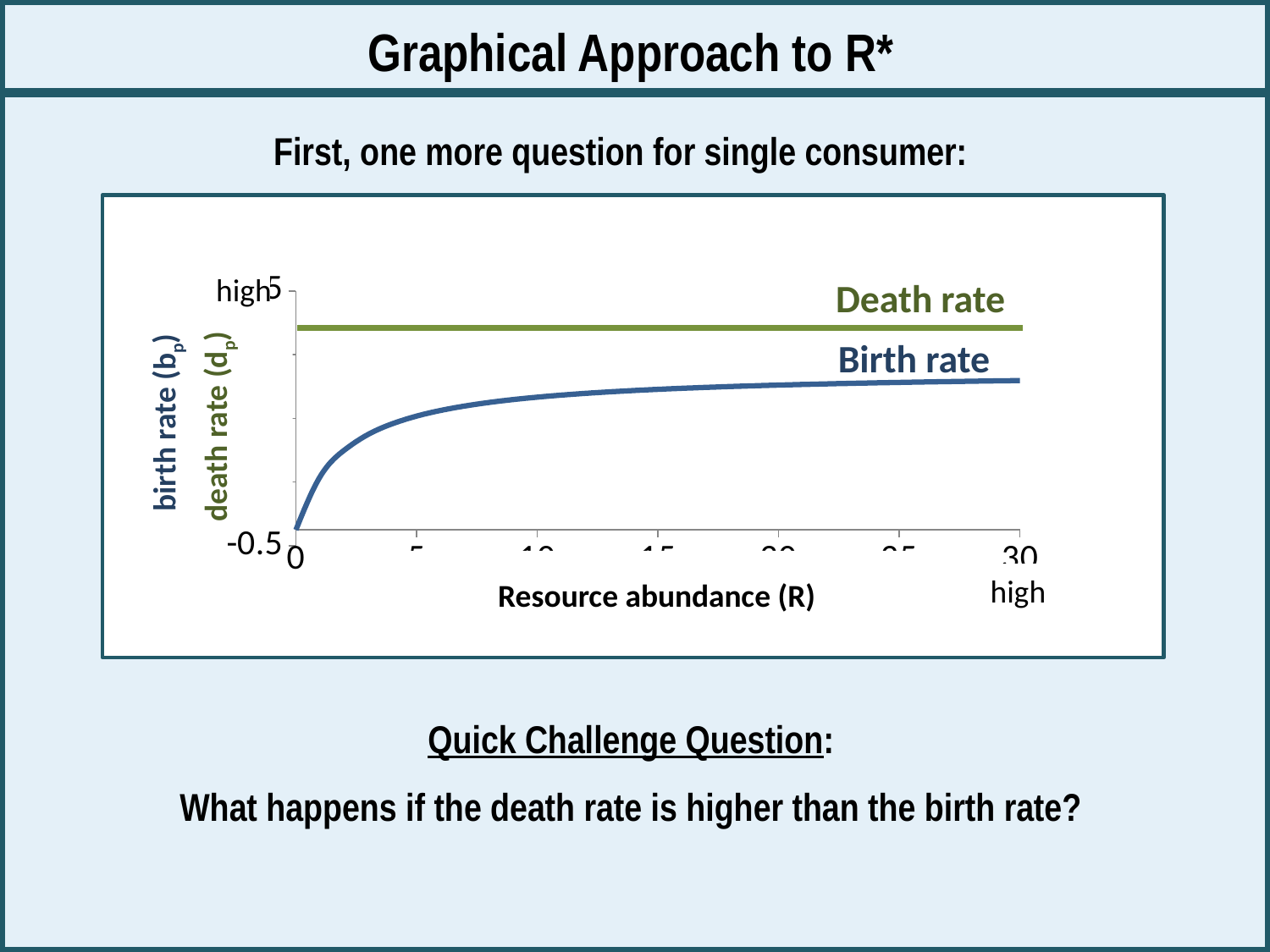
What is the highest tick value shown on the y axis? 5 Does the death rate rise, fall, or stay constant as resource abundance (R) increases? stays constant Which series is plotted as a flat horizontal line? Death rate What kind of chart is shown on the slide? line chart At a resource abundance of 30, which is larger: the death rate or the birth rate? Death rate How many series are plotted on the chart? 2 Is the death rate greater or less than 5 on the y axis? less What is the label of the x axis? Resource abundance (R) Does the birth rate rise or fall as resource abundance (R) increases? rises What is the highest tick value shown on the x axis? 30 What is the lowest tick value shown on the y axis? -0.5 Which series has the lower value at a resource abundance of 0? Birth rate